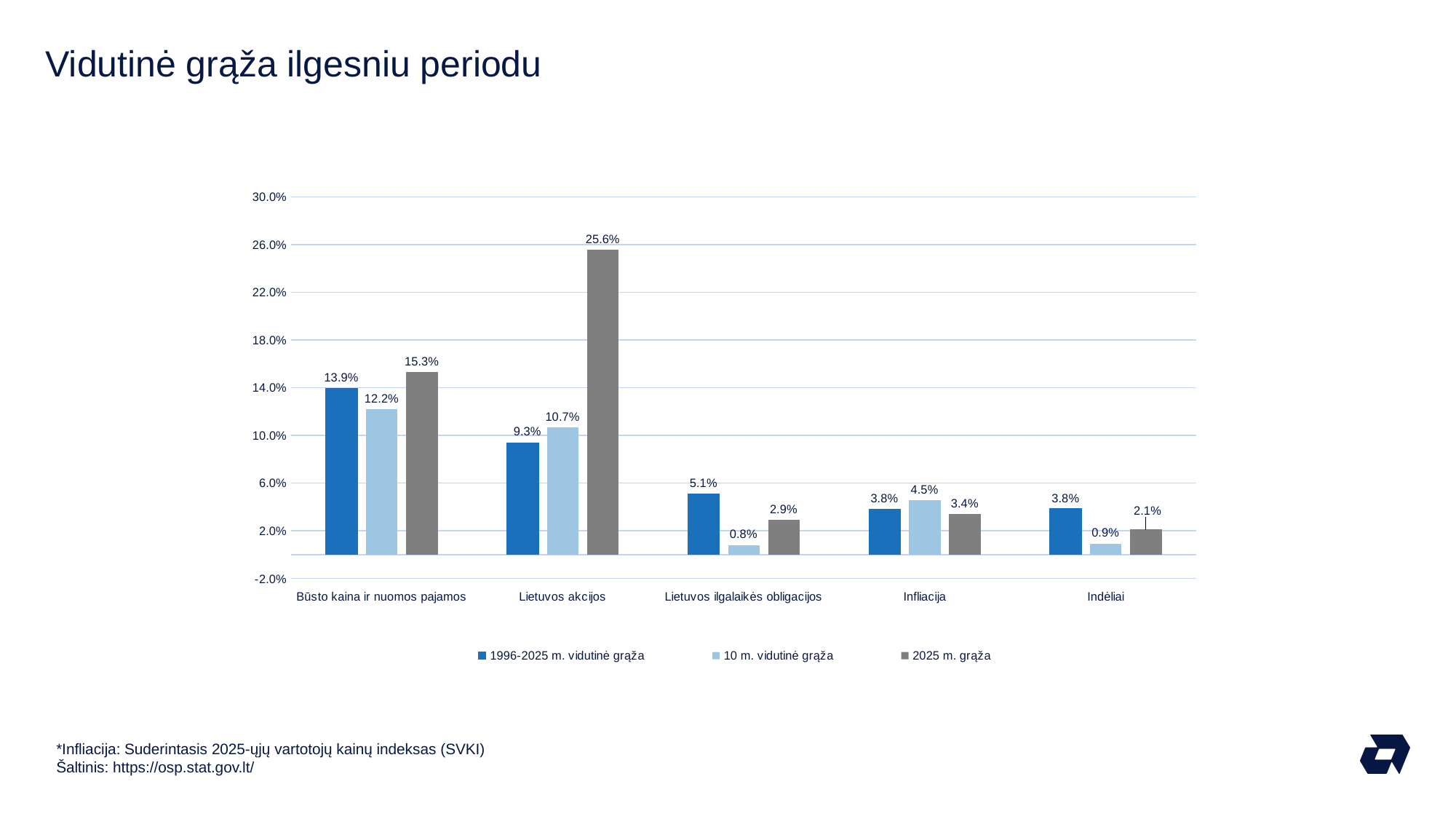
What is the 1996-2025 m. vidutinė grąža value for Būsto kaina ir nuomos pajamos? 13.9% Is the 2025 m. grąža value for Būsto kaina ir nuomos pajamos greater or less than 14.0%? greater How many categories are shown on the x axis? 5 What is the 2025 m. grąža value for Lietuvos akcijos? 25.6% How many series does the legend list? 3 Which is larger for Infliacija: the 10 m. vidutinė grąža or the 2025 m. grąža? 10 m. vidutinė grąža Which category has the highest 2025 m. grąža value? Lietuvos akcijos What is the 2025 m. grąža value for Indėliai? 2.1% Which category has the lowest 10 m. vidutinė grąža value? Lietuvos ilgalaikės obligacijos What kind of chart is shown on the slide? Bar chart What is the 10 m. vidutinė grąža value for Lietuvos ilgalaikės obligacijos? 0.8% What is the difference between the 2025 m. grąža and the 1996-2025 m. vidutinė grąža for Lietuvos akcijos? 16.3%